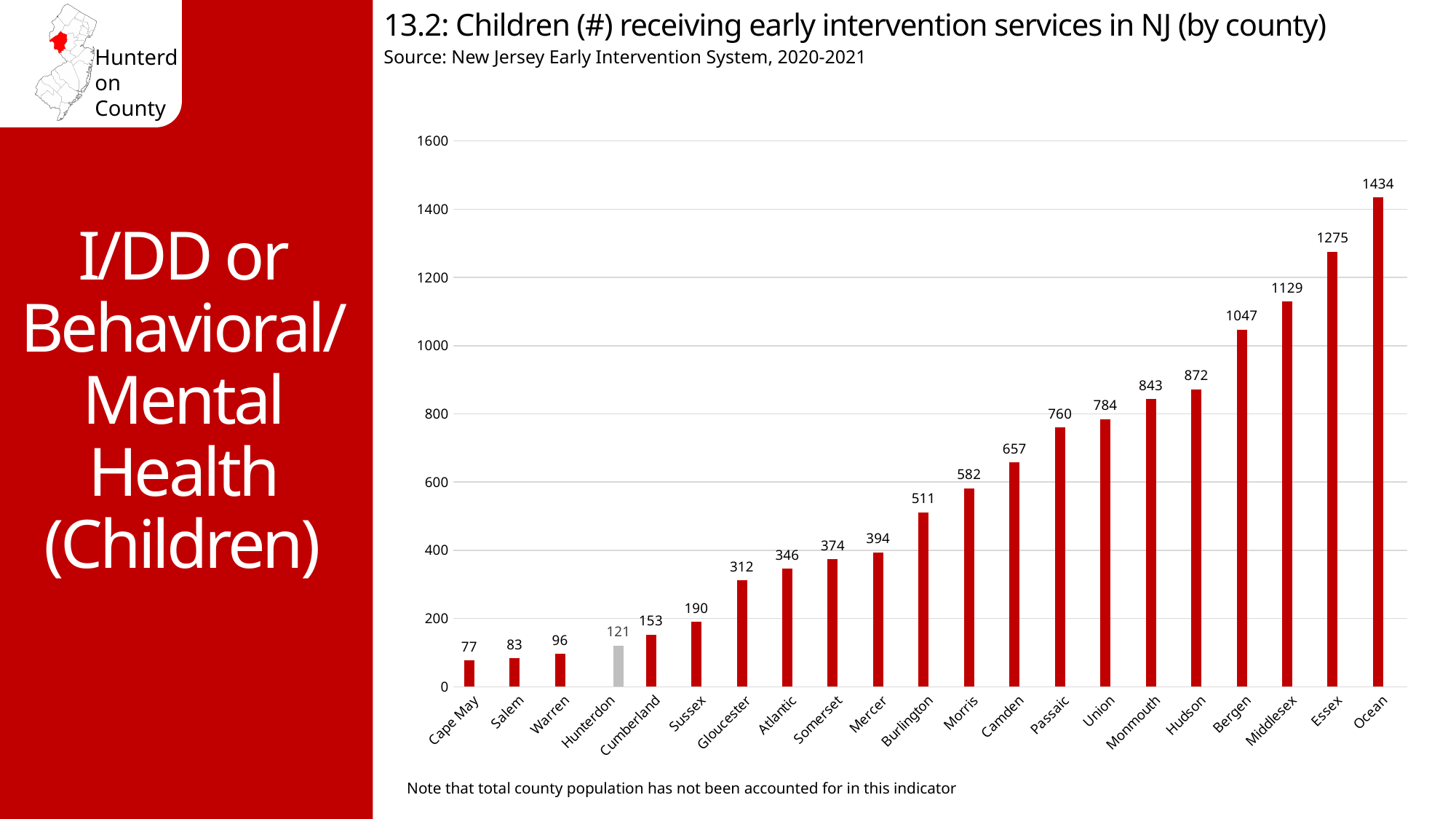
What kind of chart is shown on the slide? Bar chart What is the difference between the values for Hunterdon and Warren? 25 How many children received early intervention services in Hunterdon County? 121 What is the value shown for Essex? 1275 Which county has the highest number of children receiving early intervention services? Ocean Which county has the lowest number of children receiving early intervention services? Cape May Which has a larger value, Passaic or Camden? Passaic What is the difference between the values for Ocean and Essex? 159 Which bar is coloured differently (grey) from the others? Hunterdon Is the value for Bergen greater or less than 1000? greater How many counties are shown on the x axis? 21 What is the value shown for Burlington? 511